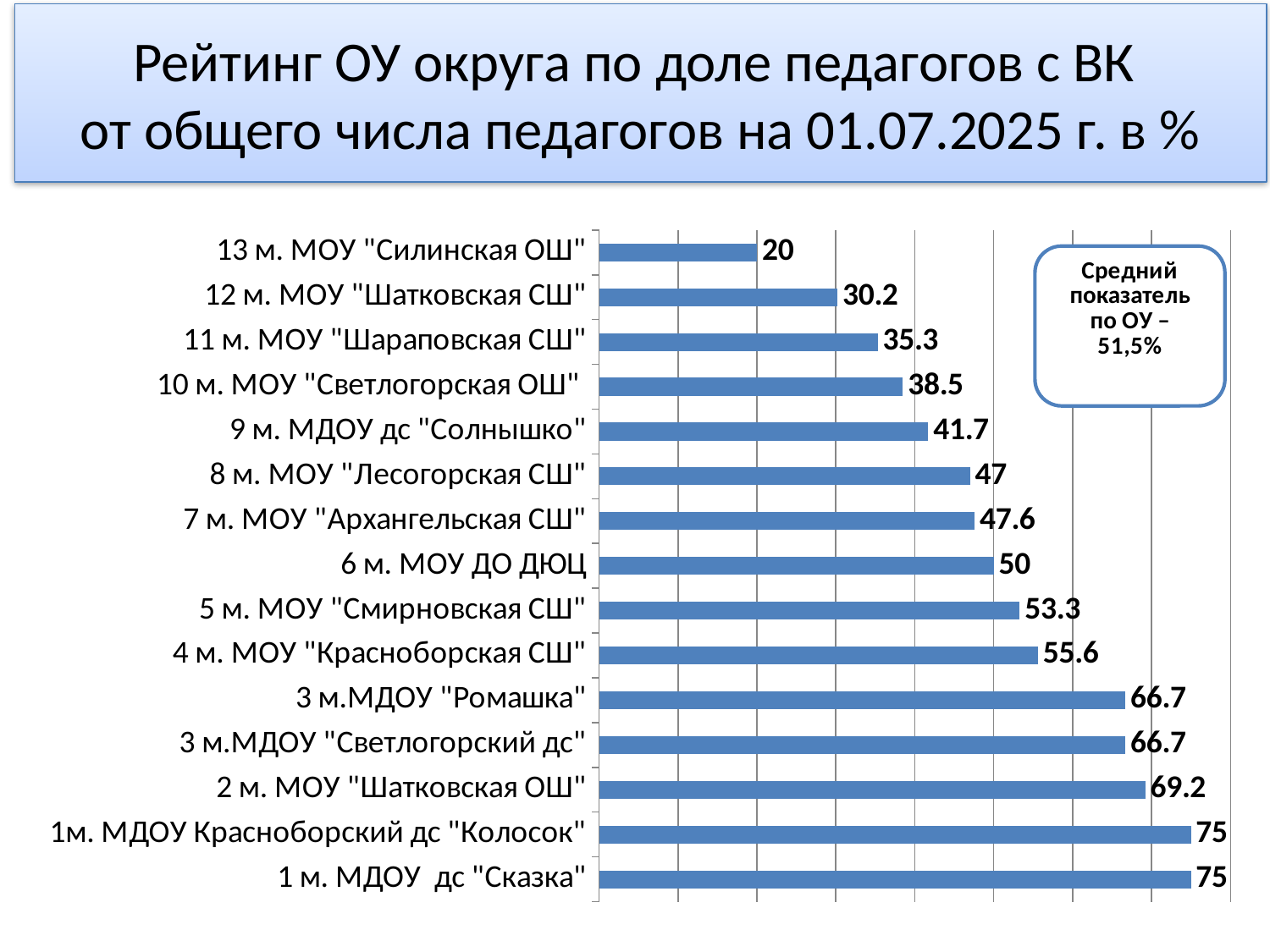
What value is shown for МОУ ДО ДЮЦ? 50 What average value across institutions (средний показатель по ОУ) is stated in the box on the chart? 51,5% Which has a larger value: МОУ "Смирновская СШ" or МОУ "Светлогорская ОШ"? МОУ "Смирновская СШ" What is the difference between the value for МДОУ дс "Сказка" and the value for МОУ "Силинская ОШ"? 55 How many institutions are listed on the chart? 15 What kind of chart is shown on the slide? Bar chart What value is shown for МДОУ дс "Солнышко"? 41.7 Is the value for МОУ "Шараповская СШ" greater or less than 40? less What value is shown for МОУ "Силинская ОШ"? 20 What is the difference between the value for МОУ "Смирновская СШ" and the value for МОУ ДО ДЮЦ? 3.3 Which institution has the lowest value on the chart? МОУ "Силинская ОШ" What value is shown for МОУ "Шатковская ОШ"? 69.2